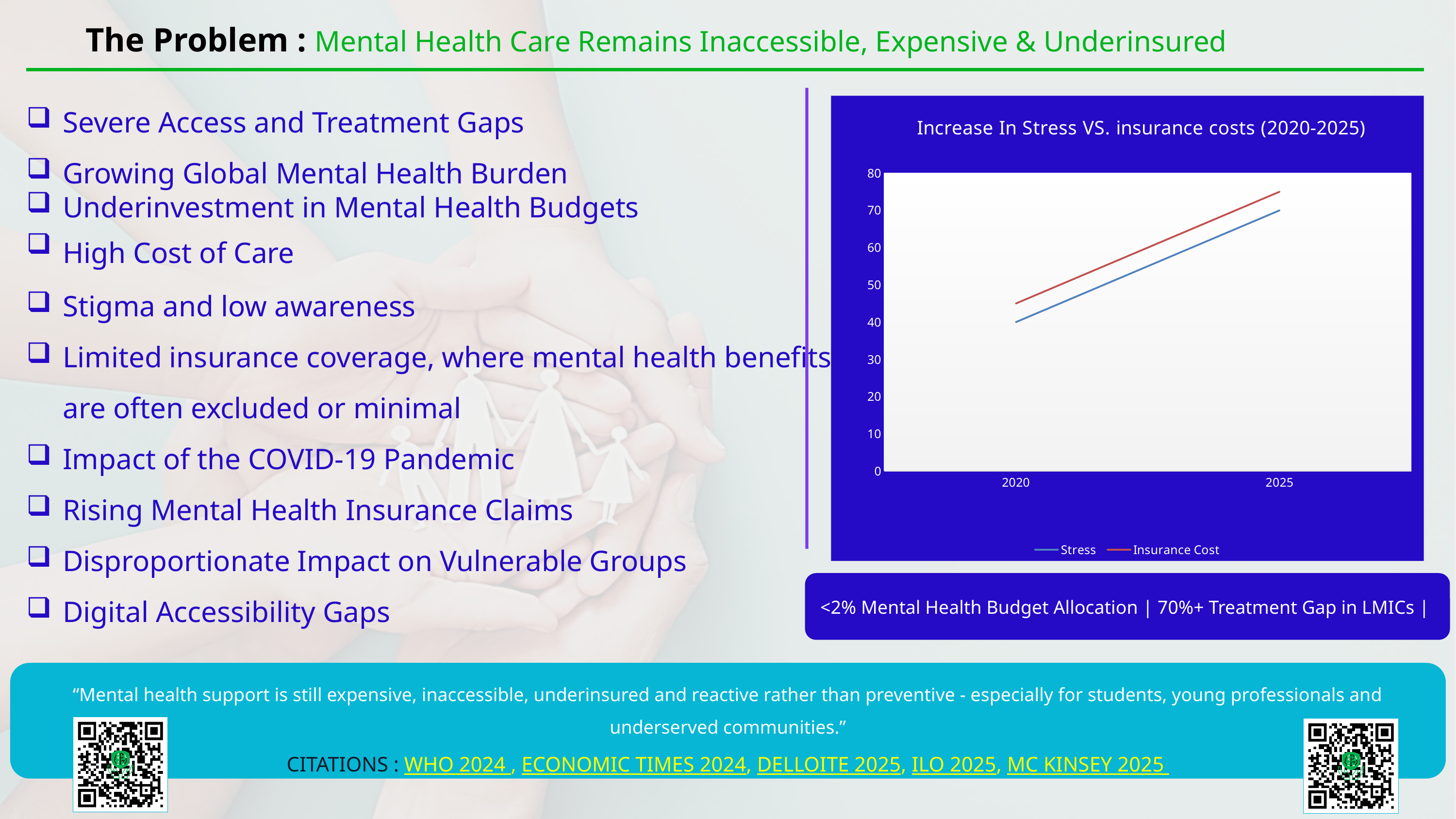
What is the title of the chart? Increase In Stress VS. insurance costs (2020-2025) How many series does the chart legend list? 2 What type of chart is shown on the slide? line chart Is the Stress value in 2020 greater or less than 50? less Which series are listed in the chart legend? Stress, Insurance Cost Does the Insurance Cost line rise or fall from 2020 to 2025? rise How many years are labelled on the x axis of the chart? 2 Is the Insurance Cost value in 2020 greater or less than 30? greater Is the Insurance Cost value in 2025 greater or less than 70? greater In 2025, which series has the higher value, Stress or Insurance Cost? Insurance Cost Does the Stress line rise or fall from 2020 to 2025? rise